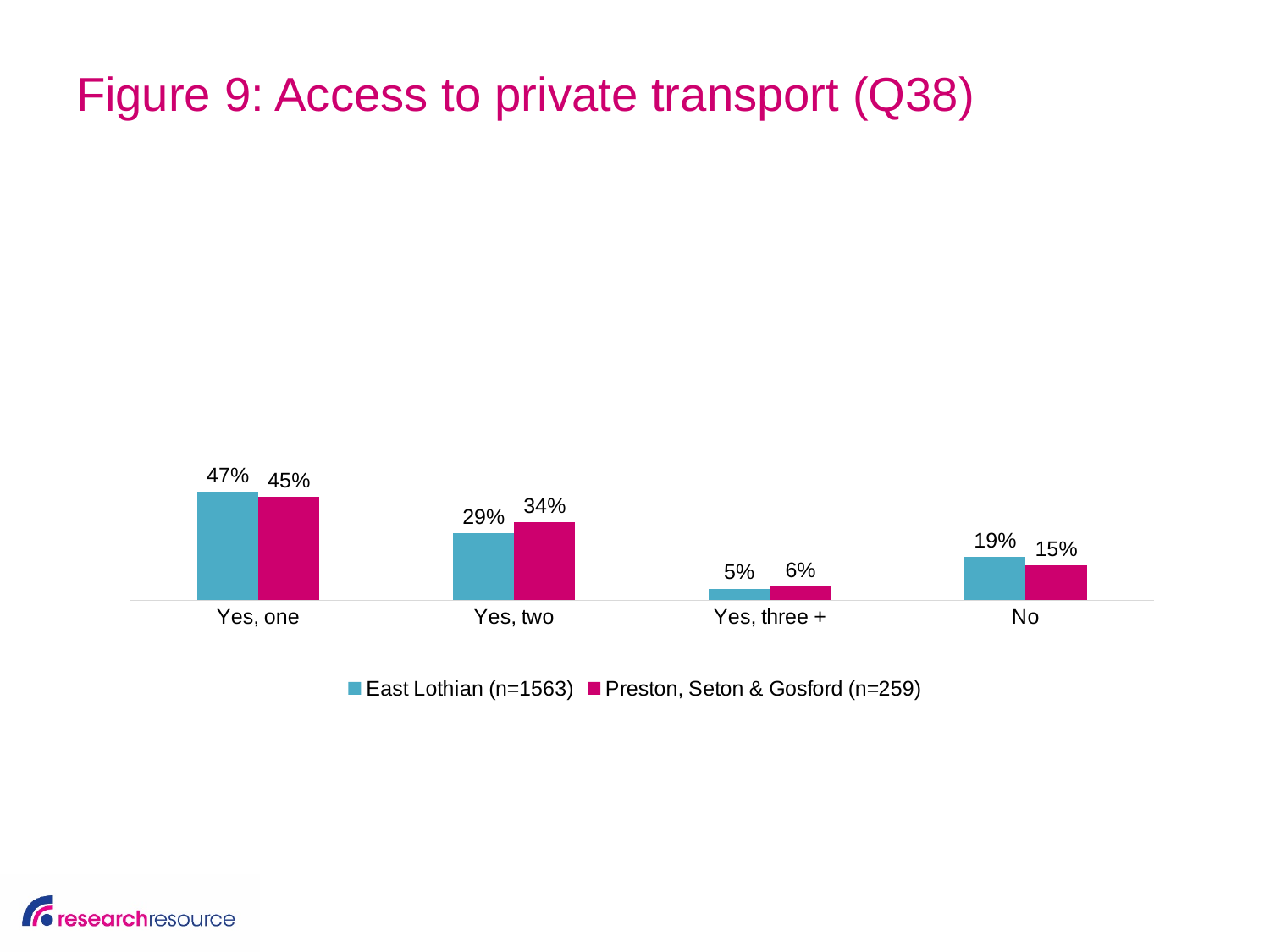
How many categories are shown on the x axis? 4 What is the value for Preston, Seton & Gosford (n=259) in the 'Yes, three +' category? 6% Which category has the highest value for East Lothian (n=1563)? Yes, one What kind of chart is shown on the slide? Bar chart Which category has the lowest value for Preston, Seton & Gosford (n=259)? Yes, three + What is the value for East Lothian (n=1563) in the 'No' category? 19% What is the value for East Lothian (n=1563) in the 'Yes, one' category? 47% What is the difference between East Lothian (n=1563) and Preston, Seton & Gosford (n=259) in the 'No' category? 4% What is the value for Preston, Seton & Gosford (n=259) in the 'Yes, two' category? 34% In the 'Yes, one' category, which series has the larger value? East Lothian (n=1563) What is the difference between East Lothian (n=1563) and Preston, Seton & Gosford (n=259) in the 'Yes, two' category? 5% How many series does the legend list? 2